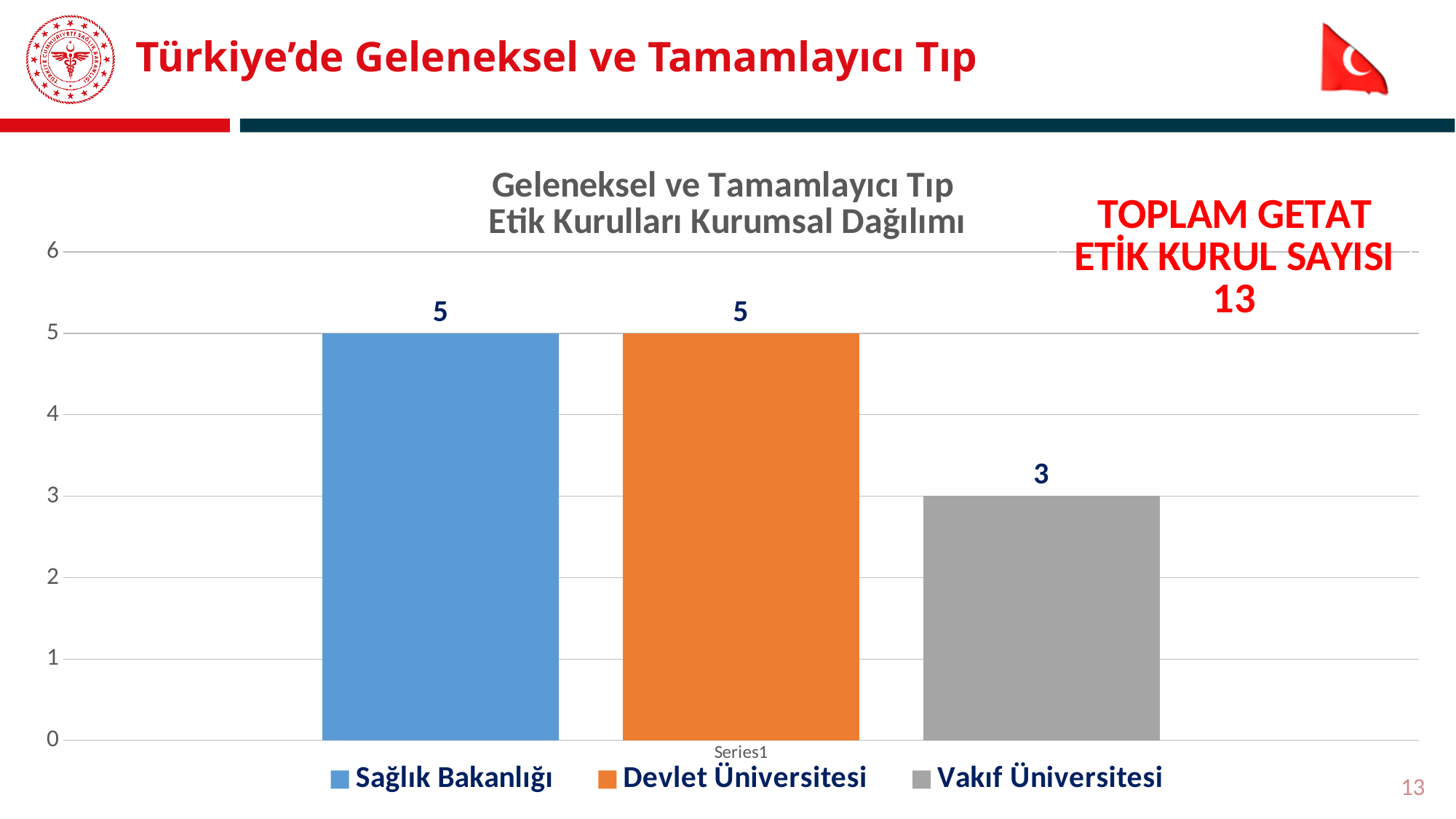
What is the difference between the values for Devlet Üniversitesi and Vakıf Üniversitesi? 2 What colour is the bar for Devlet Üniversitesi? orange What is the title of the chart? Geleneksel ve Tamamlayıcı Tıp Etik Kurulları Kurumsal Dağılımı What is the value for Sağlık Bakanlığı? 5 How many bars are shown in the chart? 3 What kind of chart is shown on the slide? bar chart What is the value for Vakıf Üniversitesi? 3 Which category has the lowest value? Vakıf Üniversitesi Which is larger, the value for Sağlık Bakanlığı or the value for Vakıf Üniversitesi? Sağlık Bakanlığı Is the value for Vakıf Üniversitesi greater or less than 4? less How many entries does the legend list? 3 What is the value for Devlet Üniversitesi? 5